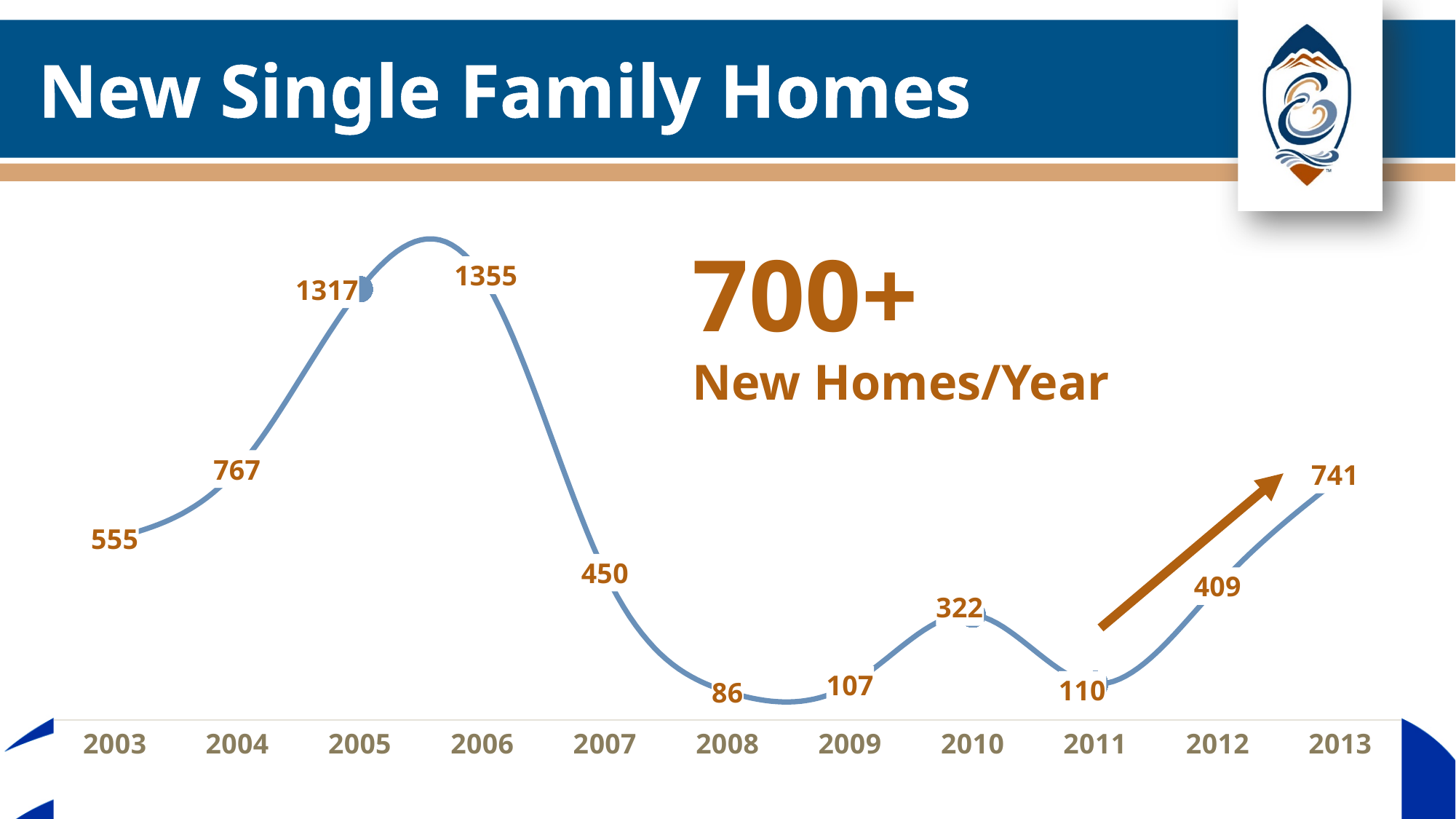
What is the difference between the values for 2005 and 2004? 550 What is the value for 2008? 86 What is the title of the slide? New Single Family Homes Which year has the highest value? 2006 Which is larger, the value for 2010 or the value for 2012? 2012 What is the value for 2006? 1355 How many years are plotted on the chart? 11 What is the value for 2013? 741 Which year has the lowest value? 2008 Do the values rise or fall from 2011 to 2013? Rise What kind of chart is shown on the slide? Line chart What is the difference between the values for 2013 and 2012? 332